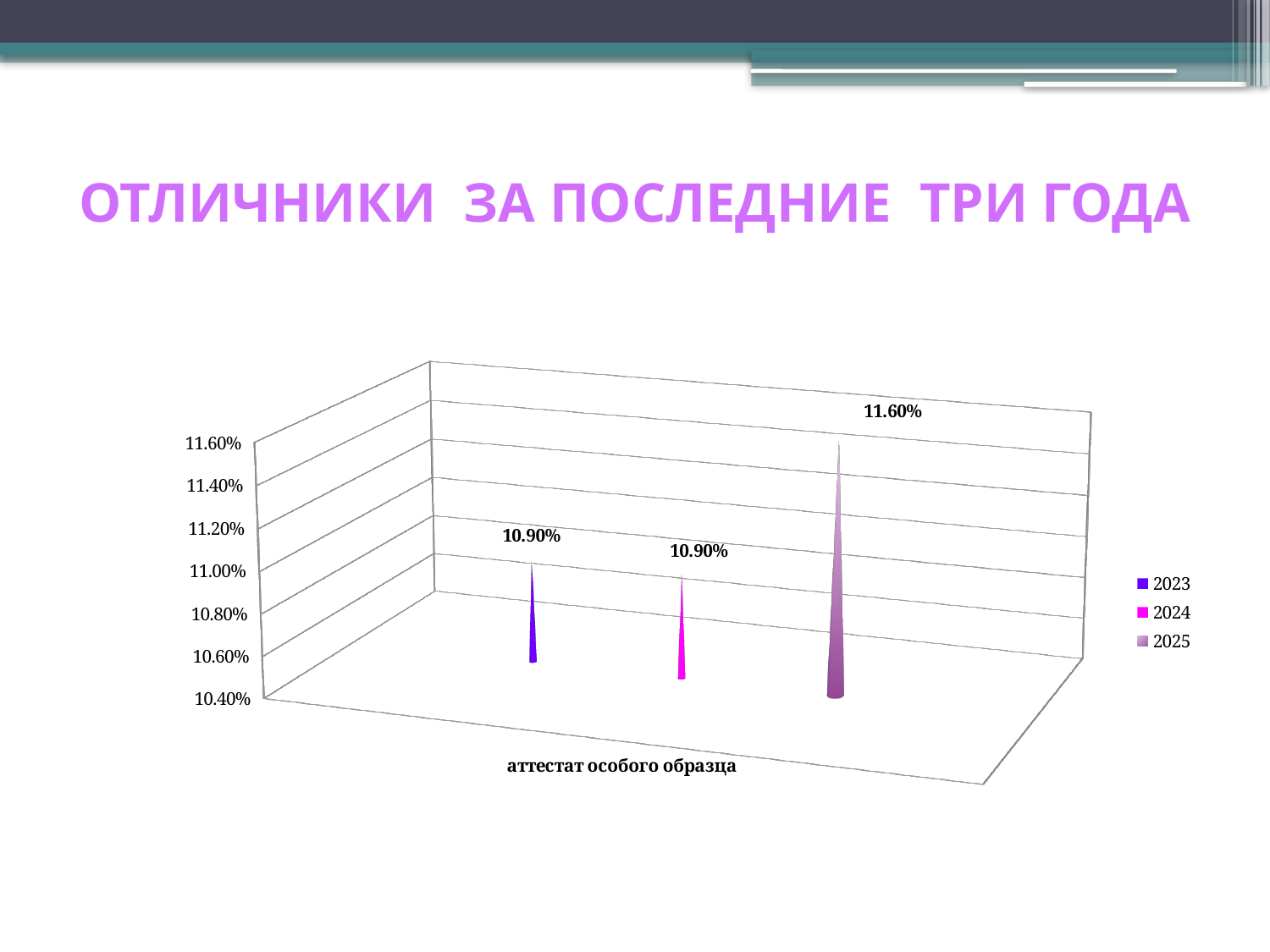
How many categories are shown on the x axis? 1 Is the value for 2023 greater or less than 11.00%? less What kind of chart is shown on the slide? bar chart How many series does the legend list? 3 What is the category label shown on the x axis? аттестат особого образца What is the value for 2025 in the chart? 11.60% What is the value for 2024 in the chart? 10.90% Is the value for 2025 greater or less than 11.00%? greater What is the difference between the values for 2025 and 2023? 0.70% Which is larger, the value for 2025 or the value for 2024? 2025 Which year has the highest value in the chart? 2025 What is the value for 2023 in the chart? 10.90%